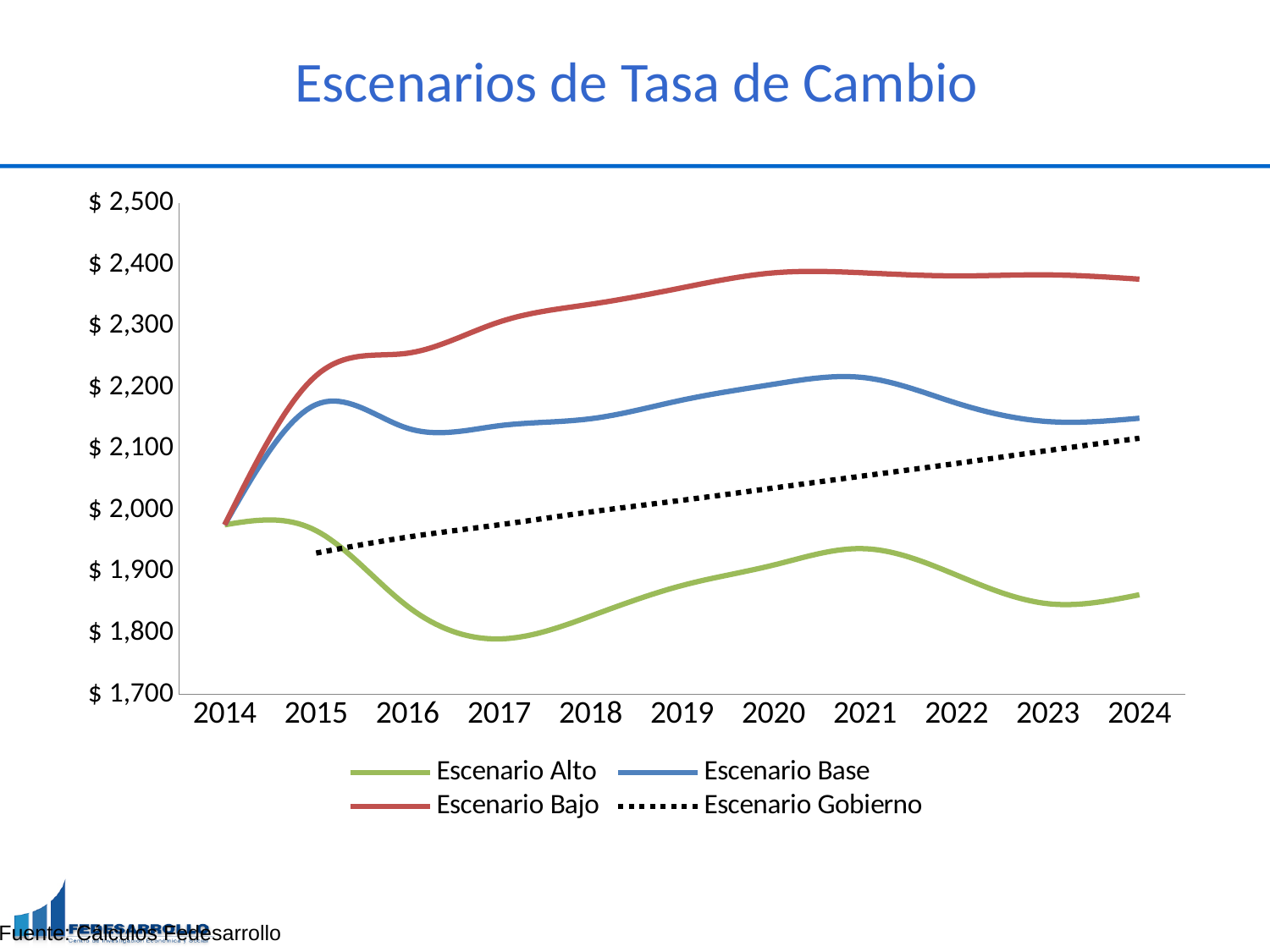
What is the title of the chart? Escenarios de Tasa de Cambio What kind of chart is shown on the slide? Line chart Is the value for Escenario Bajo in 2015 greater or less than $ 2,200? greater Is the value for Escenario Alto in 2016 greater or less than $ 1,900? less Is the value for Escenario Bajo in 2020 greater or less than $ 2,300? greater Which series has the lowest value in 2017? Escenario Alto How many series does the legend list? 4 Does the Escenario Gobierno line rise or fall from 2015 to 2024? Rises How many years are shown along the x axis? 11 Which series has the highest value in 2020? Escenario Bajo Which series is drawn as a dotted line? Escenario Gobierno